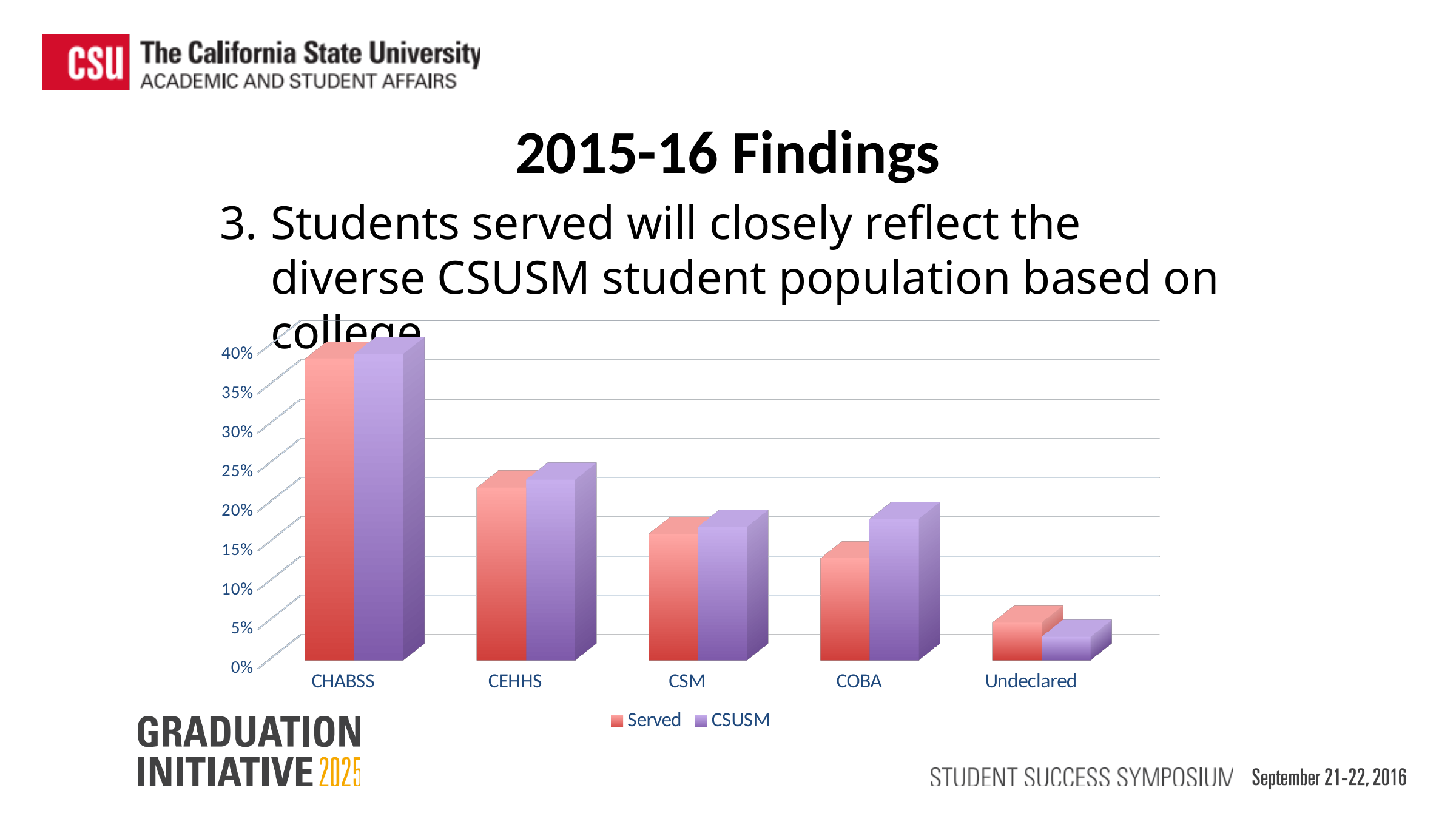
For COBA, which is larger: the Served value or the CSUSM value? CSUSM Do the Served values rise or fall moving from CHABSS to Undeclared along the x axis? fall What are the two series names listed in the chart's legend? Served and CSUSM Is the Served value for Undeclared greater or less than 10%? less Is the Served value for COBA greater or less than 20%? less What kind of chart is shown on the slide? Bar chart Which is larger: the Served value for CHABSS or the Served value for CEHHS? CHABSS How many series does the chart's legend list? 2 How many colleges/categories are shown on the x axis of the chart? 5 Which category has the highest Served value? CHABSS Is the Served value for CHABSS greater or less than 30%? greater Which category has the lowest Served value? Undeclared